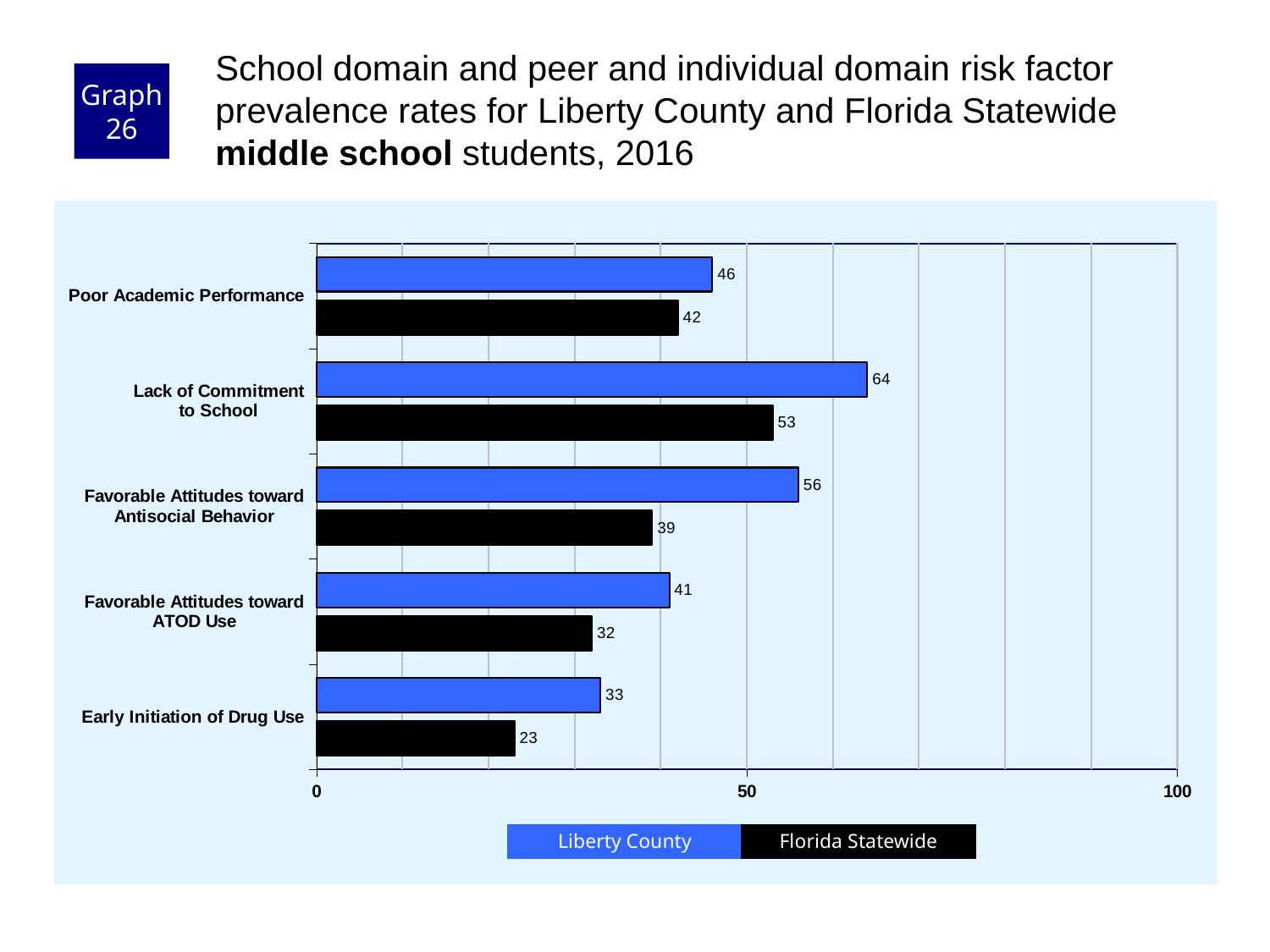
What is the Florida Statewide value for Favorable Attitudes toward Antisocial Behavior? 39 Is the Liberty County value for Favorable Attitudes toward ATOD Use greater or less than 50? less What kind of chart is shown on the slide? Bar chart How many series does the legend list? 2 Which colour represents Florida Statewide in the chart? Black What is the difference between the Liberty County and Florida Statewide values for Favorable Attitudes toward Antisocial Behavior? 17 Which risk factor has the highest Liberty County value? Lack of Commitment to School What is the Liberty County value for Lack of Commitment to School? 64 What is the Florida Statewide value for Early Initiation of Drug Use? 23 How many risk factors are shown on the chart? 5 Which is larger for Poor Academic Performance: the Liberty County value or the Florida Statewide value? Liberty County Which risk factor has the lowest Florida Statewide value? Early Initiation of Drug Use